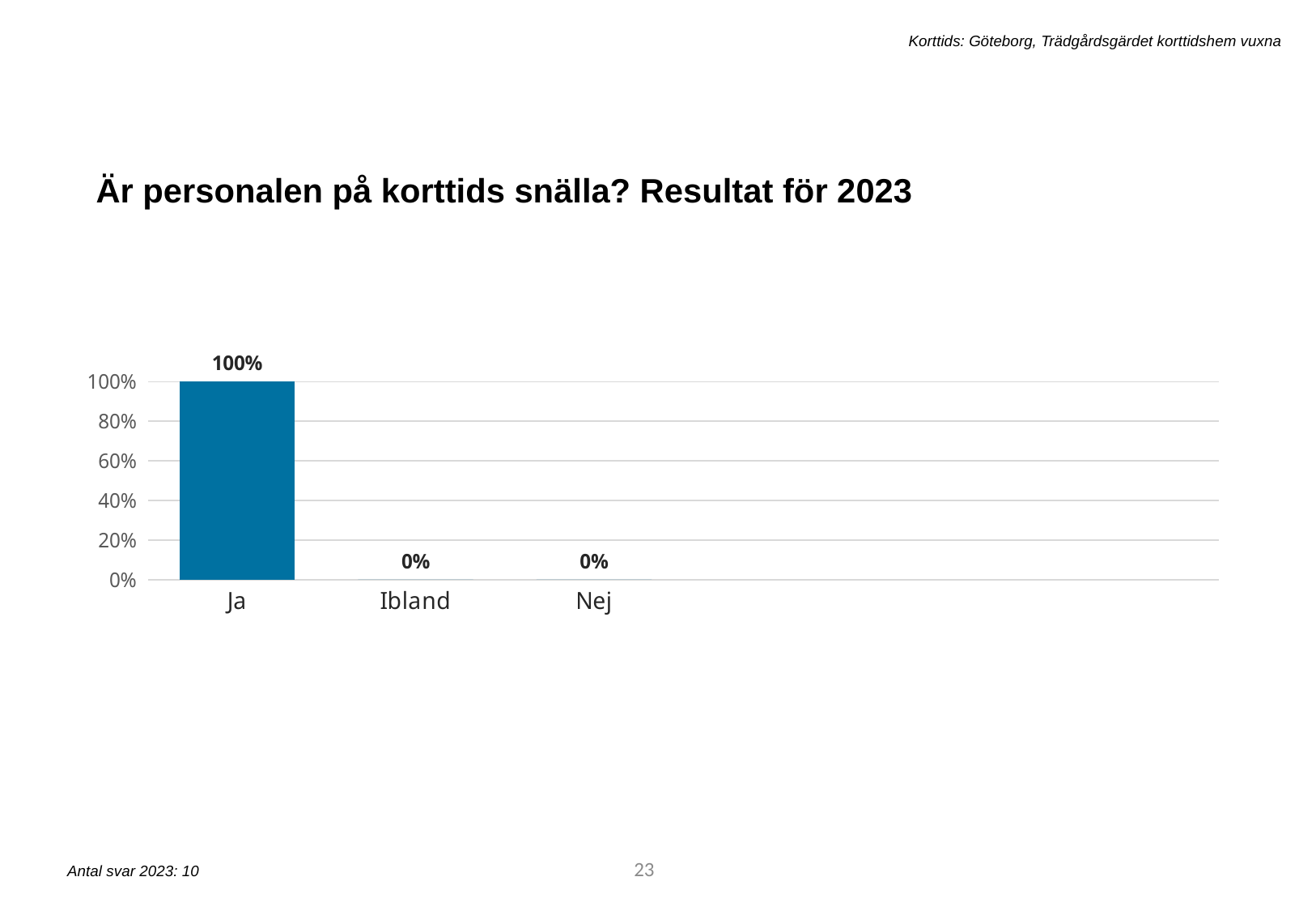
What is the value for Ja? 100% Is the value for Ja greater or less than 80%? greater Which is larger, the value for Ja or the value for Ibland? Ja What kind of chart is shown on the slide? bar chart Do the values rise or fall from Ja to Nej along the x axis? fall Which category has the highest value? Ja How many categories are shown on the x axis? 3 What is the value for Ibland? 0% What is the difference between the values for Ja and Nej? 100% What is the value for Nej? 0% What is the highest value shown on the y axis? 100% What is the title of the chart? Är personalen på korttids snälla? Resultat för 2023